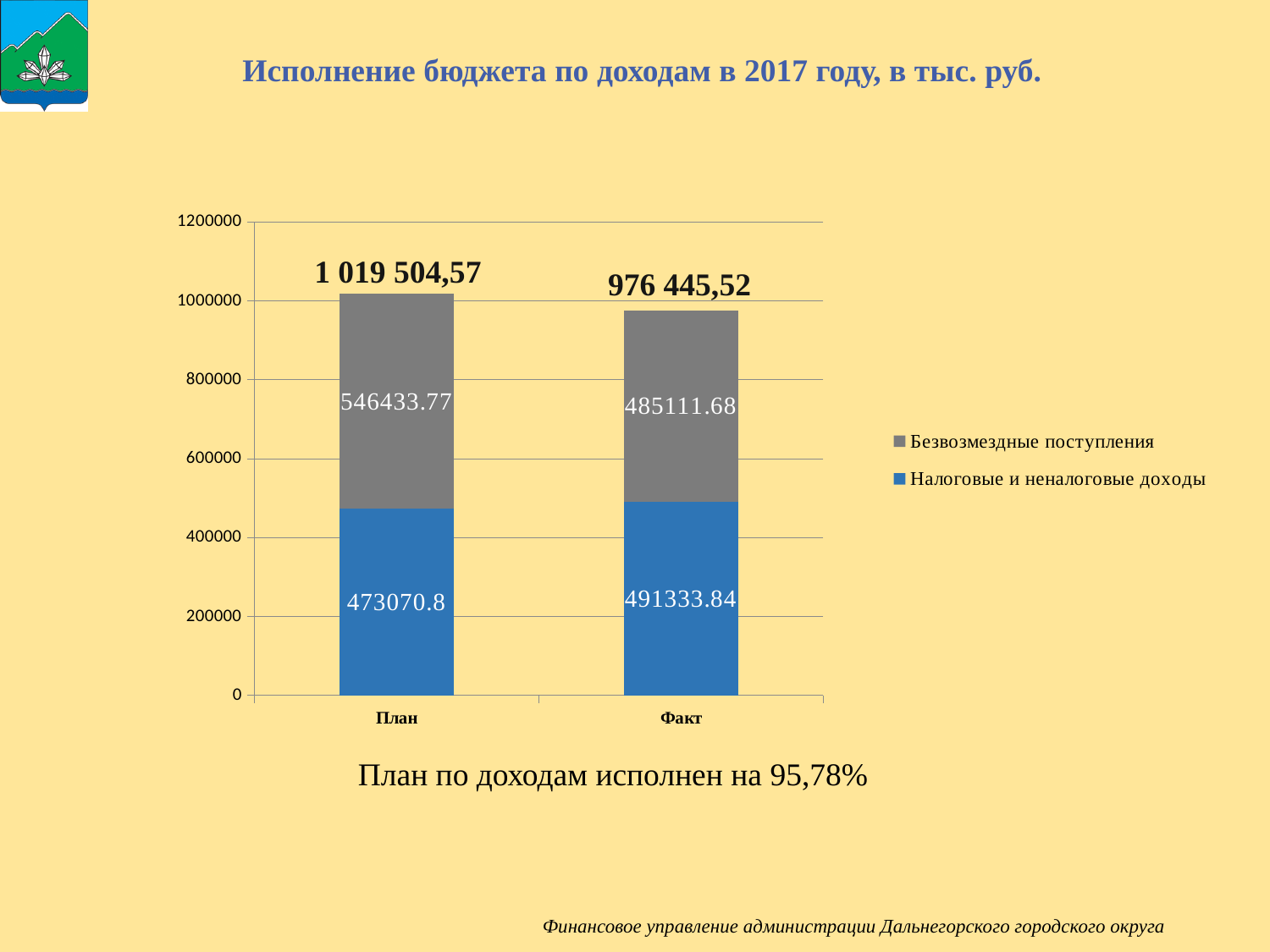
What is the total of the stacked bar for Факт? 976 445,52 What is the total of the stacked bar for План? 1 019 504,57 How many series does the legend list? 2 How many categories are shown on the x axis? 2 Which is larger: Безвозмездные поступления for План or for Факт? План What is the value of Налоговые и неналоговые доходы for Факт? 491333.84 What is the value of Безвозмездные поступления for Факт? 485111.68 What is the value of Безвозмездные поступления for План? 546433.77 What kind of chart is shown on the slide? Stacked bar chart Which category has the higher total, План or Факт? План What is the value of Налоговые и неналоговые доходы for План? 473070.8 What is the difference between Налоговые и неналоговые доходы for Факт and for План? 18263.04